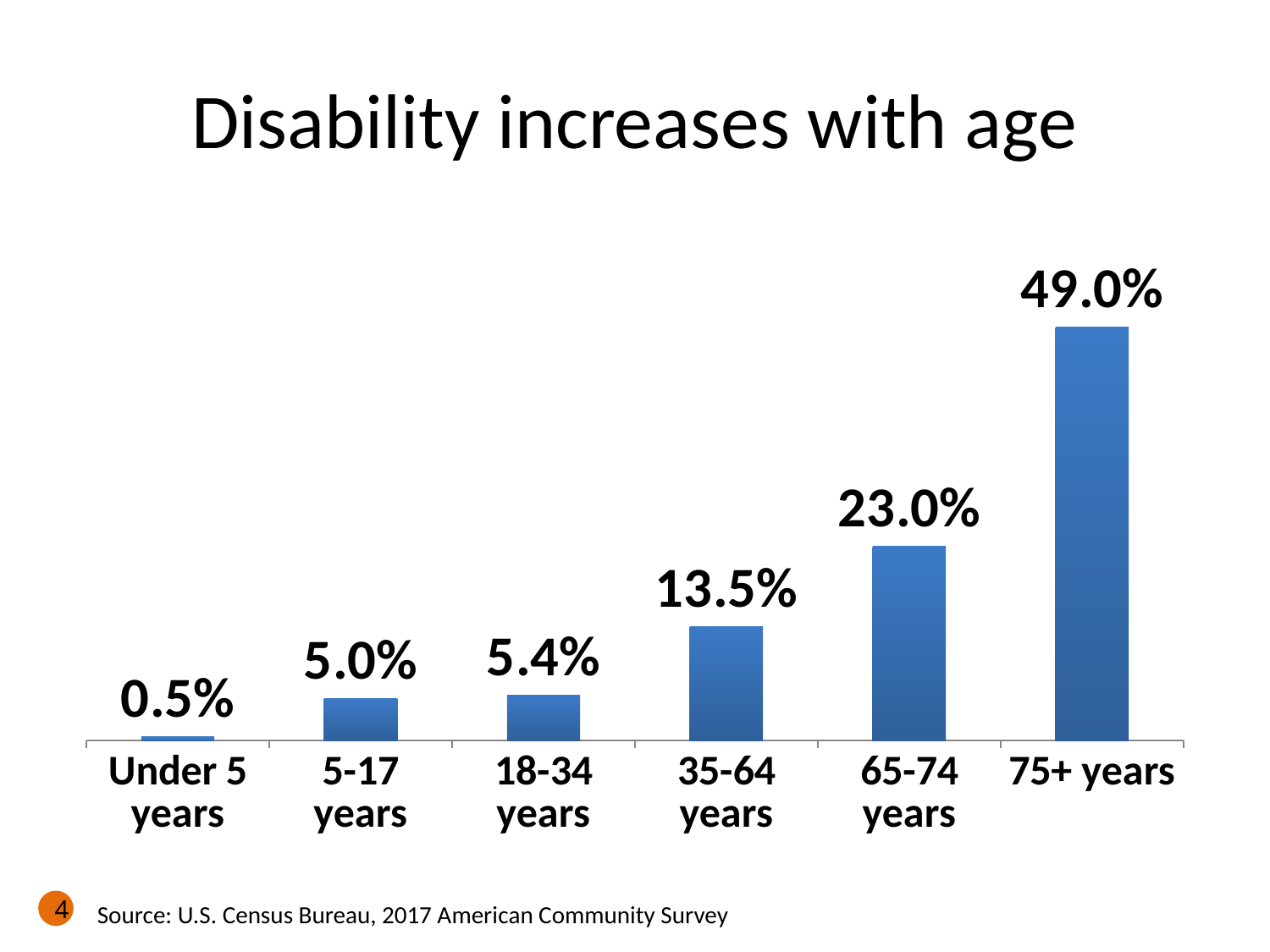
Which age group has the lowest value? Under 5 years Do the values rise or fall as age increases along the x axis? Rise Which age group has the highest value? 75+ years What kind of chart is shown on the slide? Bar chart What is the value for the 65-74 years age group? 23.0% What is the value for the 75+ years age group? 49.0% What is the difference between the values for 18-34 years and 5-17 years? 0.4% Which is larger, the value for 35-64 years or the value for 18-34 years? 35-64 years How many age groups are shown in the chart? 6 What is the difference between the values for 75+ years and 65-74 years? 26.0% What is the value for the Under 5 years age group? 0.5% What is the value for the 35-64 years age group? 13.5%